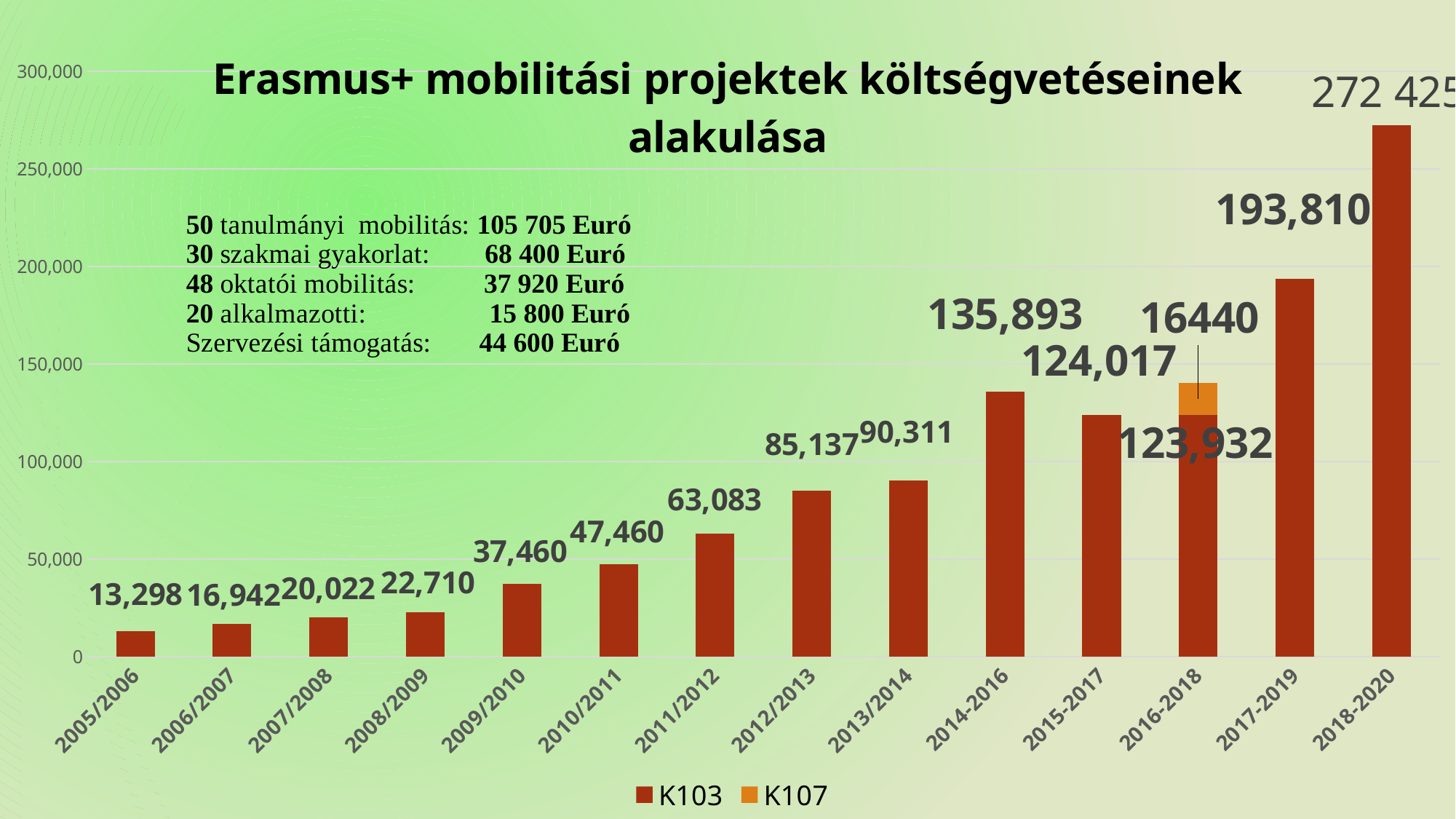
What is the total of the stacked bar for 2016-2018? 140,372 What is the value for 2011/2012? 63,083 How many series does the legend list? 2 Which category has the lowest value? 2005/2006 What is the value for 2005/2006? 13,298 What is the K107 value for 2016-2018? 16440 What is the difference between the values for 2014-2016 and 2015-2017? 11,876 How many categories are shown on the x axis? 14 Which category has the highest total value? 2018-2020 Which is larger, the value for 2014-2016 or the value for 2015-2017? 2014-2016 What kind of chart is shown on the slide? bar chart What are the two series names listed in the legend? K103 and K107